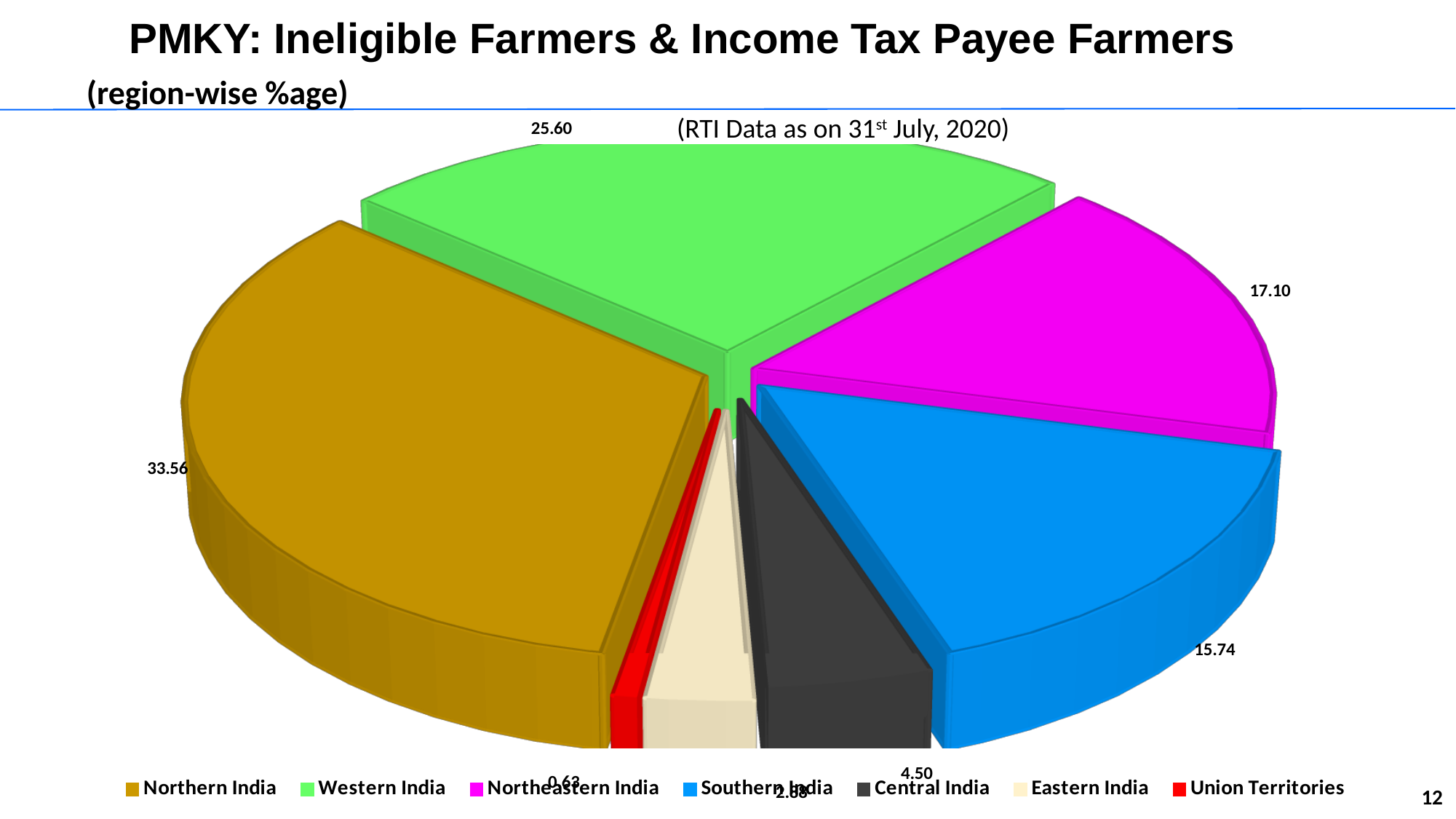
Which region has the smallest share of the pie? Union Territories What is the value shown for Northeastern India? 17.10 What is the difference between the values for Northern India and Western India? 7.96 How many regions are listed in the legend? 7 What is the value shown for Central India? 4.50 Which is larger, the value for Northeastern India or Southern India? Northeastern India Which region has the largest share of the pie? Northern India What kind of chart is shown on the slide? Pie chart Which colour represents Southern India in the legend? Blue What is the value shown for Southern India? 15.74 What is the value shown for Western India? 25.60 What is the value shown for Northern India? 33.56